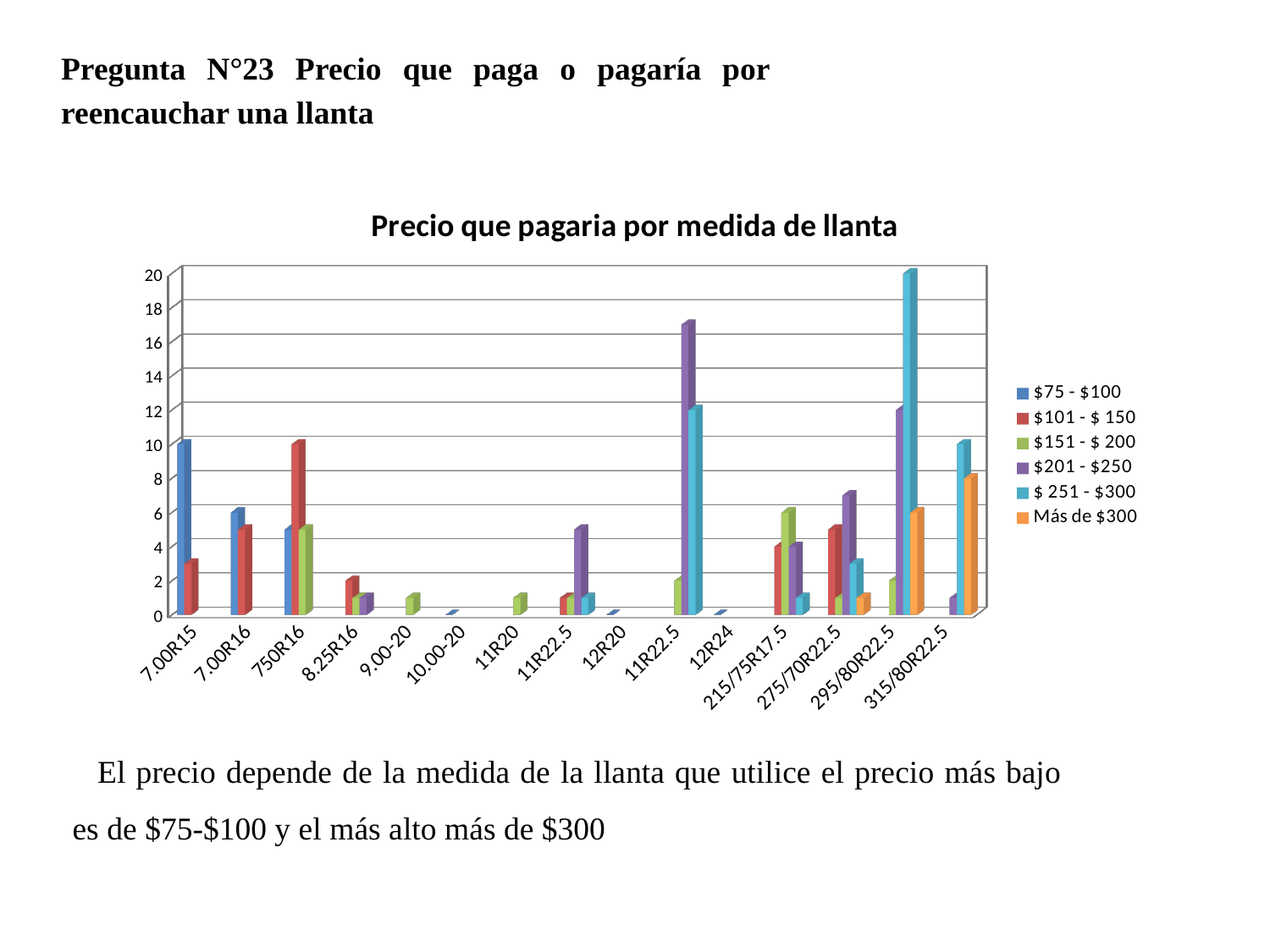
Is the value for $ 251 - $300 at 295/80R22.5 greater or less than 18? greater What is the title of the chart? Precio que pagaria por medida de llanta Which tire size has the tallest bar for the $75 - $100 series? 7.00R15 How many series does the legend list? 6 Which tire size has the tallest bar for the $ 251 - $300 series? 295/80R22.5 Is the value for $201 - $250 at 11R22.5 (the tallest purple bar) greater or less than 14? greater Is the value for $101 - $ 150 at 750R16 greater or less than 8? greater How many tire-size categories are shown on the x axis? 15 For 7.00R15, which is larger: the $75 - $100 bar or the $101 - $ 150 bar? $75 - $100 What kind of chart is shown on the slide? bar chart For 750R16, which is larger: the $75 - $100 bar or the $101 - $ 150 bar? $101 - $ 150